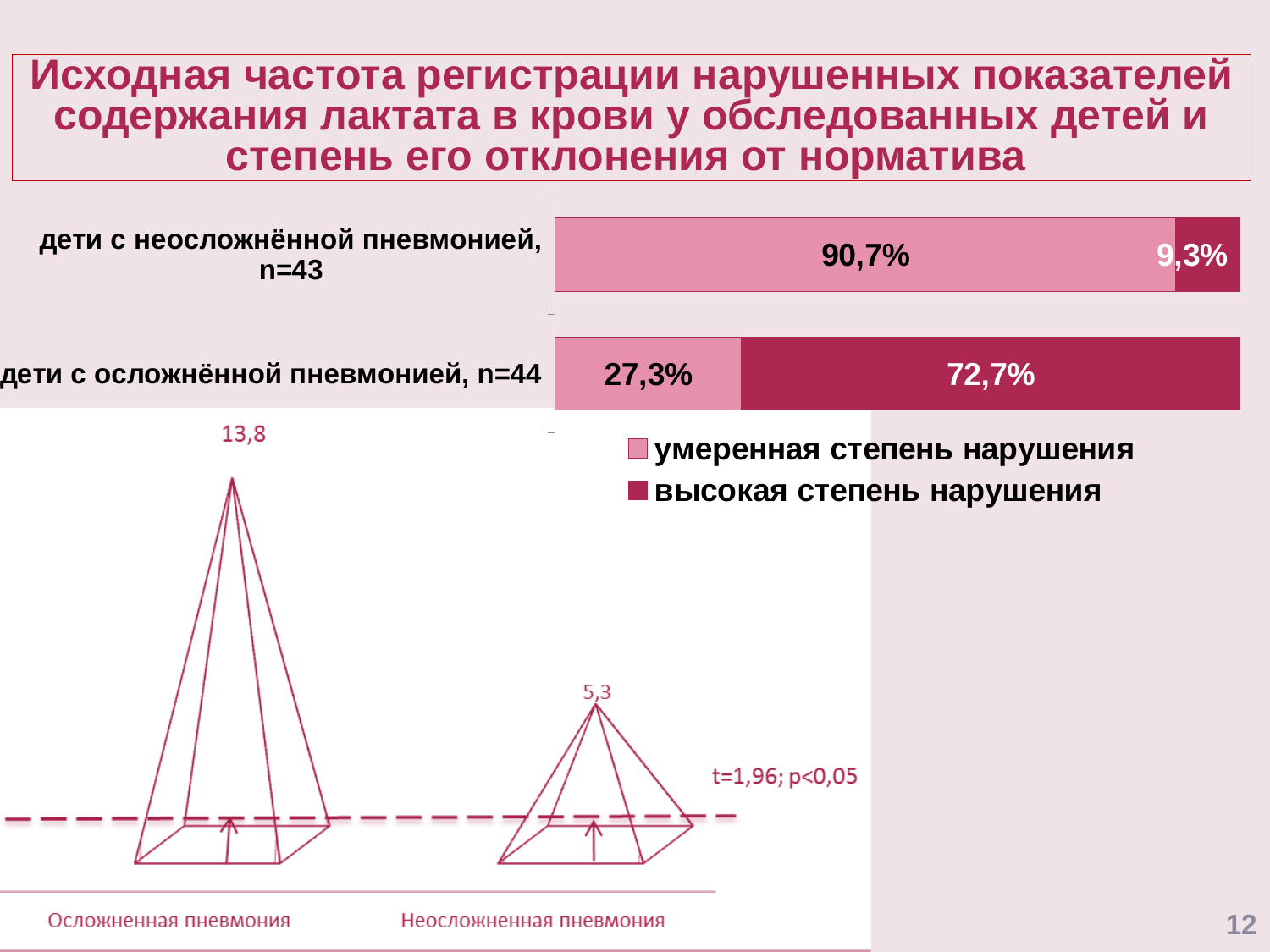
How many series does the legend of the top stacked bar chart list? 2 In the bottom-left pyramid chart, what value is shown for 'Неосложненная пневмония'? 5,3 In the bottom-left pyramid chart, what is the difference between the values for 'Осложненная пневмония' (13,8) and 'Неосложненная пневмония' (5,3)? 8,5 In the top stacked bar chart, which group has the larger share with a high degree of disturbance: children with complicated pneumonia or children with uncomplicated pneumonia? дети с осложнённой пневмонией, n=44 In the top stacked bar chart, what percentage of children with uncomplicated pneumonia (n=43) had a moderate degree of disturbance (умеренная степень нарушения)? 90,7% In the top chart, what is the total of the two segments for the bar 'дети с осложнённой пневмонией, n=44'? 100% How many categories (groups of children) are shown in the top stacked bar chart? 2 In the top stacked bar chart, what percentage of children with uncomplicated pneumonia (n=43) had a high degree of disturbance? 9,3% In the top stacked bar chart, what is the difference between the moderate-degree shares of the uncomplicated (90,7%) and complicated (27,3%) pneumonia groups? 63,4% In the top stacked bar chart, what percentage of children with complicated pneumonia (n=44) had a moderate degree of disturbance? 27,3% In the bottom-left pyramid chart, what value is shown for 'Осложненная пневмония'? 13,8 In the top stacked bar chart, what percentage of children with complicated pneumonia (n=44) had a high degree of disturbance (высокая степень нарушения)? 72,7%